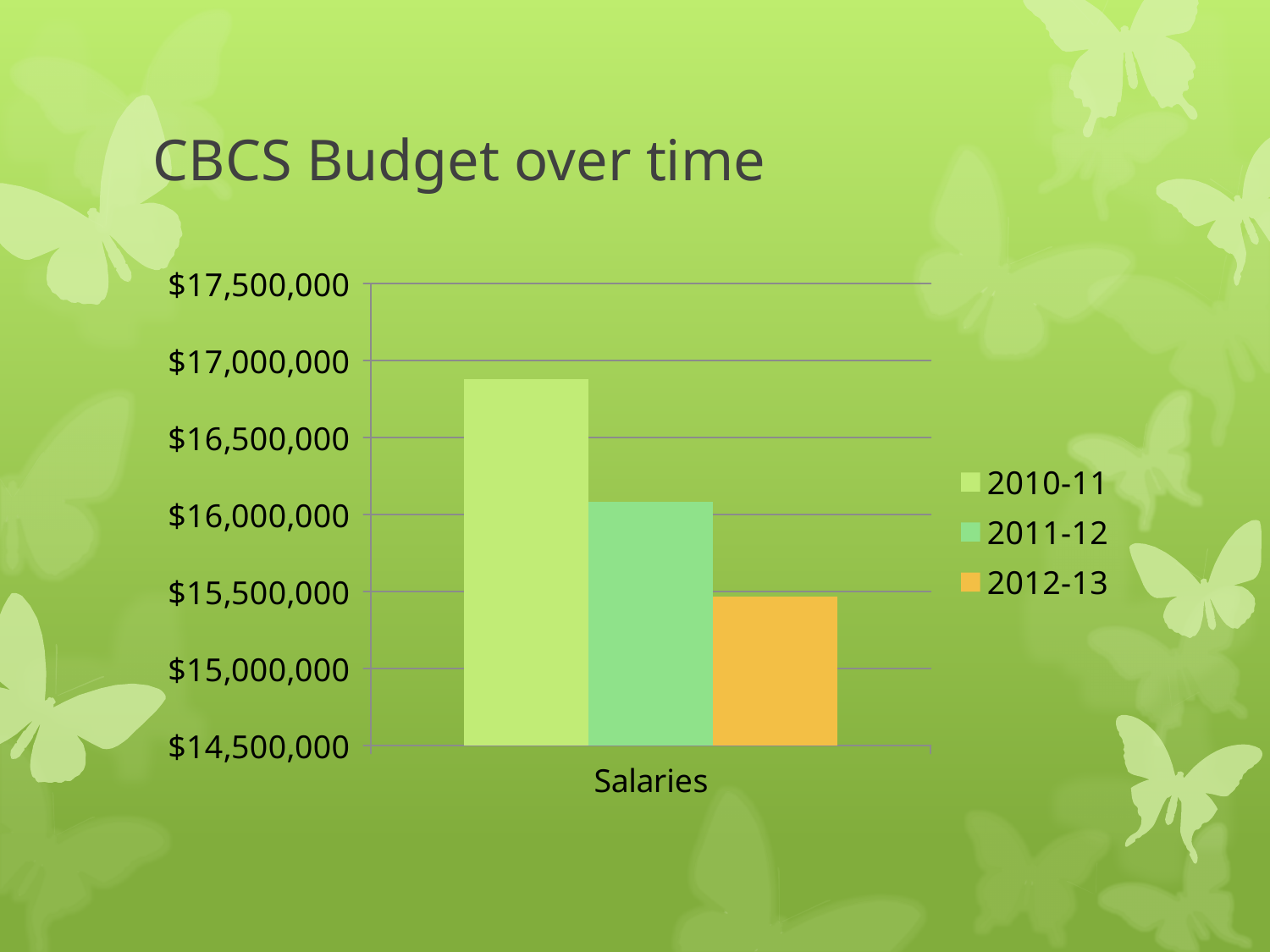
Which is larger, the Salaries value for 2010-11 or for 2011-12? 2010-11 Which year has the highest Salaries value? 2010-11 Which year has the lowest Salaries value? 2012-13 Do the Salaries values rise or fall from 2010-11 to 2012-13? fall What is the title of the slide's chart? CBCS Budget over time Is the Salaries value for 2011-12 greater or less than $16,500,000? less Is the Salaries value for 2010-11 greater or less than $16,500,000? greater How many series does the legend list? 3 How many categories are shown on the x axis? 1 What is the category label on the x axis? Salaries What kind of chart is shown on the slide? bar chart Is the Salaries value for 2012-13 greater or less than $15,000,000? greater